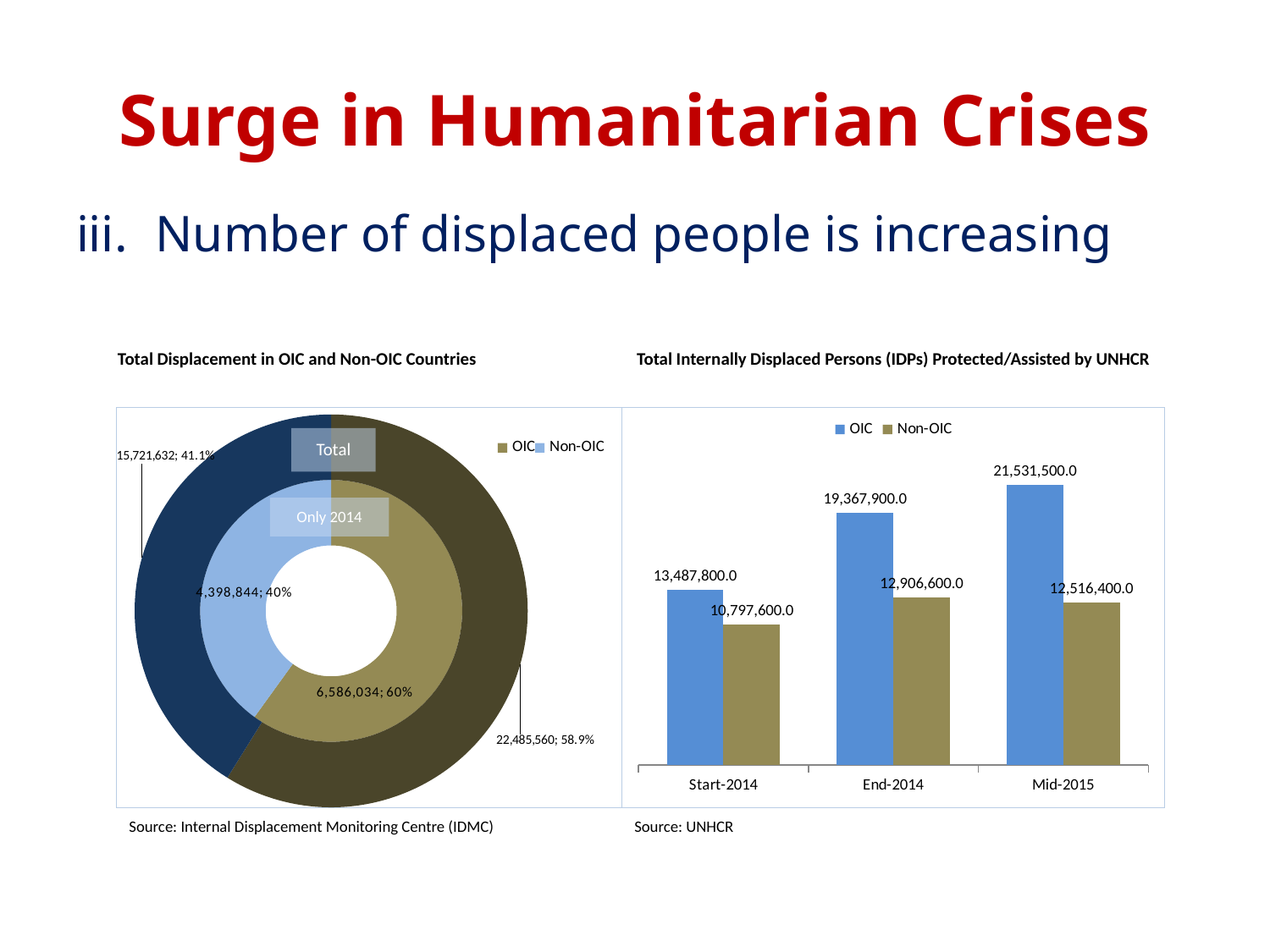
In the chart titled 'Total Internally Displaced Persons (IDPs) Protected/Assisted by UNHCR', is the Non-OIC value larger for End-2014 or Mid-2015? End-2014 In the chart titled 'Total Internally Displaced Persons (IDPs) Protected/Assisted by UNHCR', what is the OIC value for Mid-2015? 21,531,500.0 In the chart titled 'Total Internally Displaced Persons (IDPs) Protected/Assisted by UNHCR', which period has the highest OIC value? Mid-2015 In the chart titled 'Total Displacement in OIC and Non-OIC Countries', what share of the Total ring is OIC? 58.9% In the chart titled 'Total Internally Displaced Persons (IDPs) Protected/Assisted by UNHCR', how many series does the legend list? 2 In the chart titled 'Total Internally Displaced Persons (IDPs) Protected/Assisted by UNHCR', which period has the lowest Non-OIC value? Start-2014 In the chart titled 'Total Internally Displaced Persons (IDPs) Protected/Assisted by UNHCR', do the OIC values rise or fall from Start-2014 to Mid-2015? Rise In the chart titled 'Total Displacement in OIC and Non-OIC Countries', what is the Non-OIC value in the 'Only 2014' ring? 4,398,844 In the chart titled 'Total Internally Displaced Persons (IDPs) Protected/Assisted by UNHCR', what is the Non-OIC value for Start-2014? 10,797,600.0 In the chart titled 'Total Internally Displaced Persons (IDPs) Protected/Assisted by UNHCR', what is the difference between the OIC and Non-OIC values for Mid-2015? 9,015,100.0 What kind of chart is the one titled 'Total Internally Displaced Persons (IDPs) Protected/Assisted by UNHCR'? Bar chart In the chart titled 'Total Internally Displaced Persons (IDPs) Protected/Assisted by UNHCR', how many periods are shown on the x axis? 3